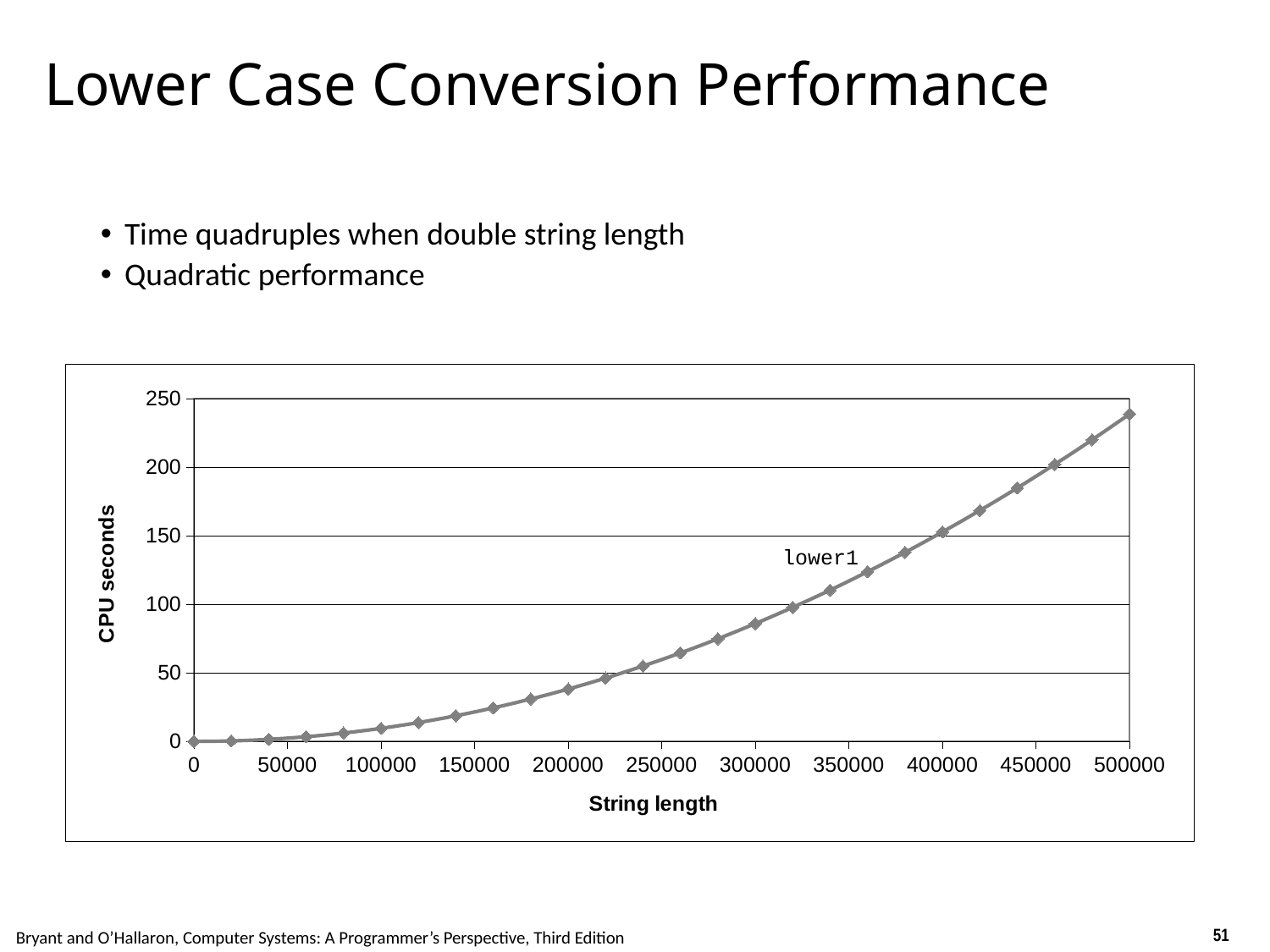
Is the CPU seconds value at string length 200000 greater or less than 50? less At which string length is the CPU time lowest? 0 Which has the larger CPU seconds value: string length 200000 or string length 400000? 400000 How many data points are plotted on the chart? 26 Do the CPU seconds rise or fall as string length increases? rise What is the title of the y axis? CPU seconds Is the CPU seconds value at string length 300000 greater or less than 100? less Is the CPU seconds value at string length 100000 greater or less than 50? less At which string length is the CPU time highest? 500000 What is the label of the series plotted on the chart? lower1 What kind of chart is shown on the slide? line chart